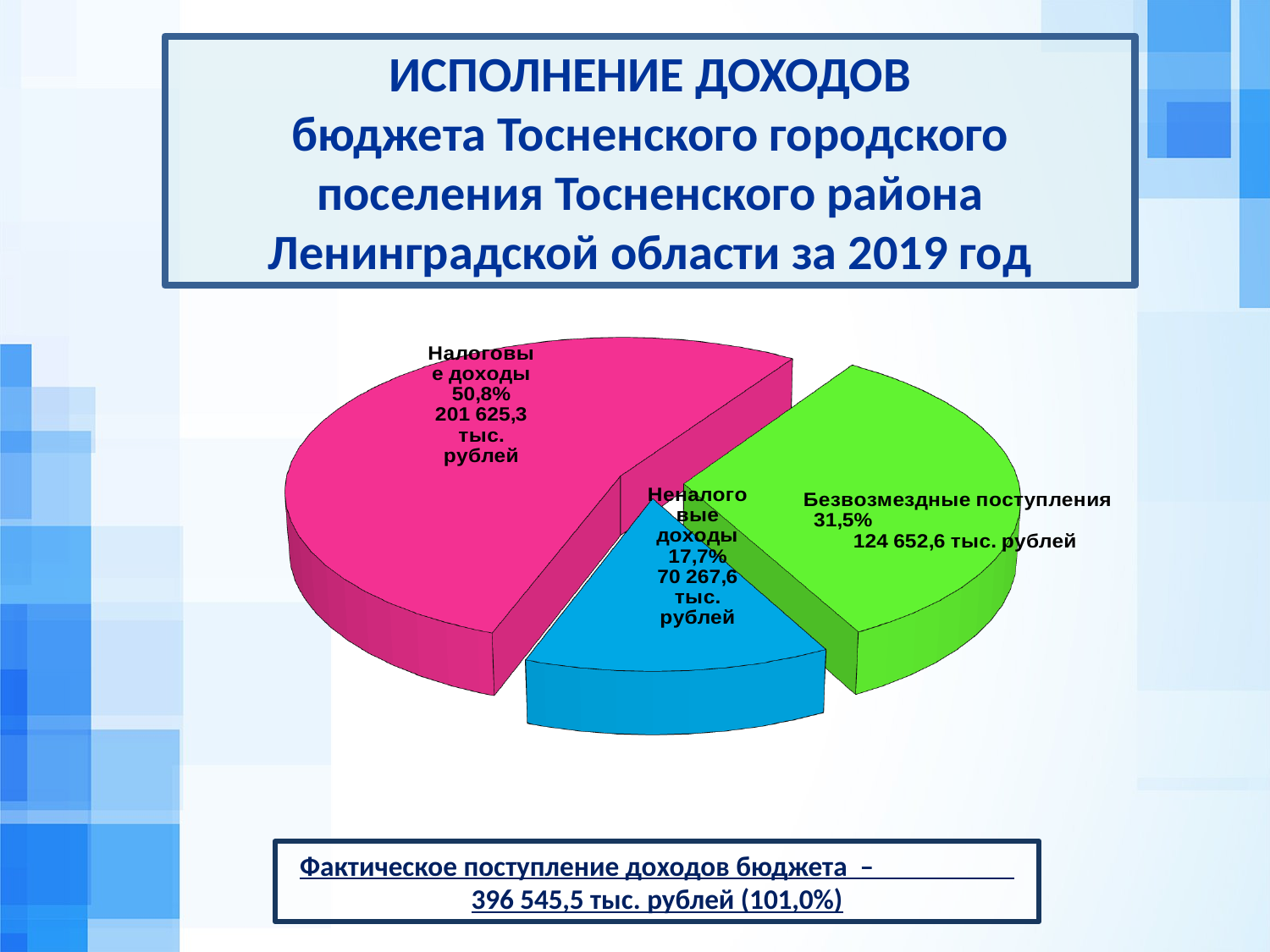
What is the difference in percentage points between the Налоговые доходы share and the Неналоговые доходы share? 33,1 What is the value shown for Безвозмездные поступления in thousand rubles? 124 652,6 тыс. рублей What share of the pie does Неналоговые доходы represent? 17,7% What is the value shown for Налоговые доходы in thousand rubles? 201 625,3 тыс. рублей Which is larger: Безвозмездные поступления or Неналоговые доходы? Безвозмездные поступления Which slice of the pie chart is the smallest? Неналоговые доходы What is the value shown for Неналоговые доходы in thousand rubles? 70 267,6 тыс. рублей How many slices does the pie chart have? 3 What share of the pie does Налоговые доходы represent? 50,8% Which slice of the pie chart is the largest? Налоговые доходы What share of the pie does Безвозмездные поступления represent? 31,5% What kind of chart is shown on the slide? Pie chart